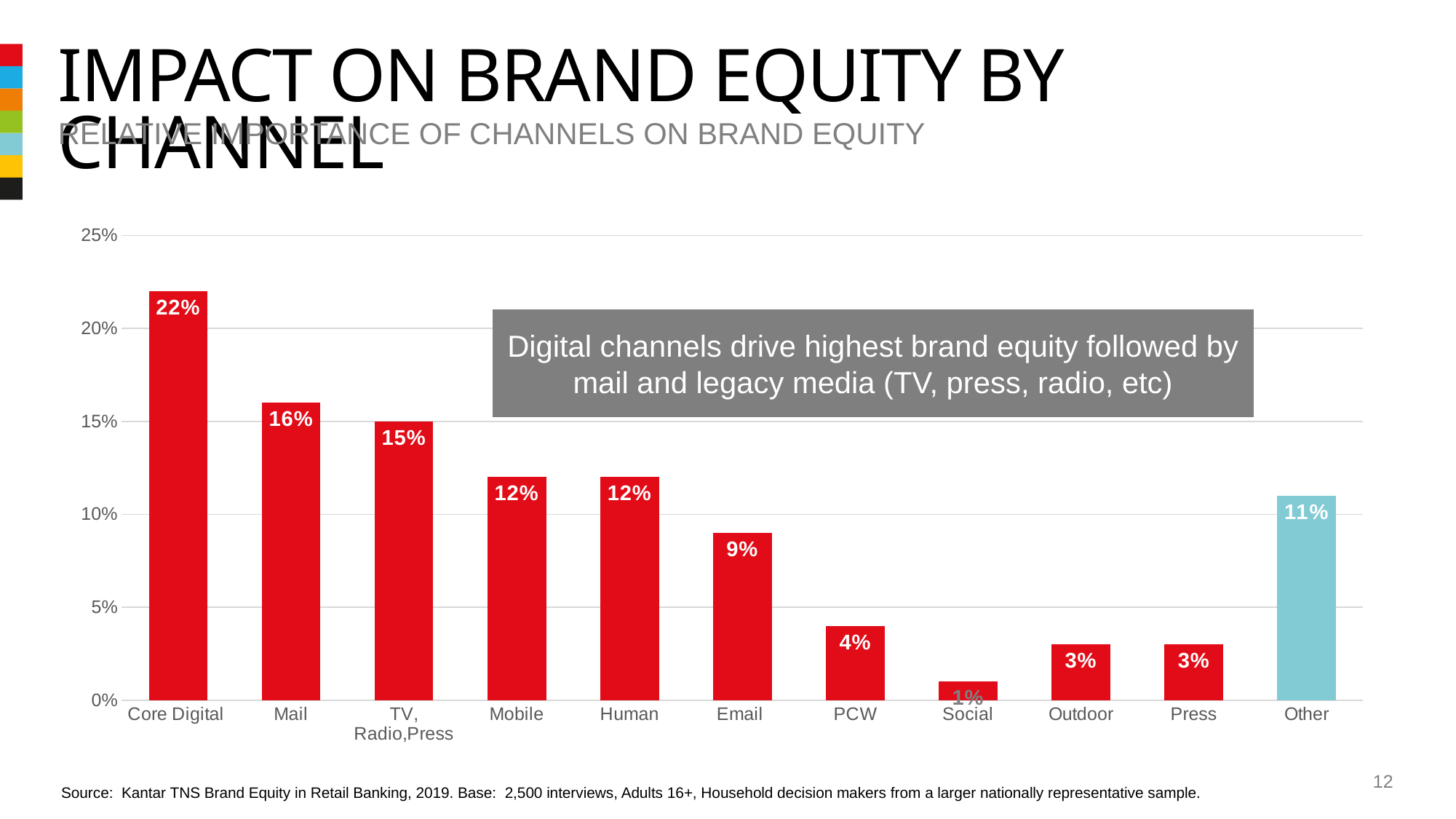
Is the value for Mobile greater or less than 10%? greater What is the value for Other? 11% Which channel has the highest value? Core Digital Which bar is shown in a different colour (light blue) from the others? Other What kind of chart is shown on the slide? Bar chart What is the value for Core Digital? 22% What is the difference between the values for Email and PCW? 5% What is the value for Email? 9% Which channel has the lowest value? Social What is the difference between the values for Core Digital and Mail? 6% How many channels are shown on the x axis? 11 Which is larger, the value for Mail or the value for TV, Radio,Press? Mail